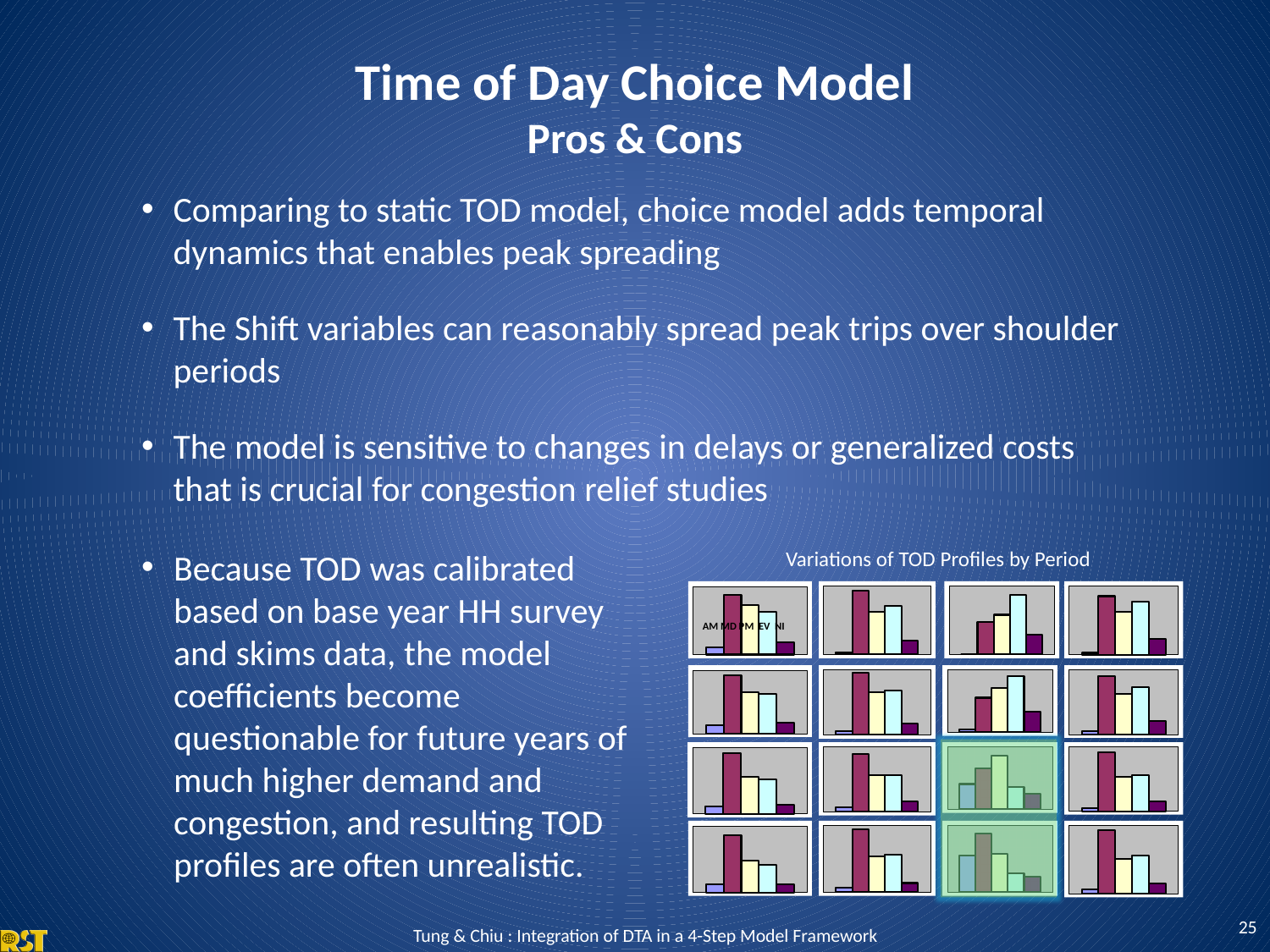
In the top-left chart of the 'Variations of TOD Profiles by Period' grid, which is larger, AM or MD? MD In the top-left chart of the 'Variations of TOD Profiles by Period' grid, which category has the shortest bar? AM What are the category labels shown on the top-left chart of the 'Variations of TOD Profiles by Period' grid? AM, MD, PM, EV, NI How many bars (categories) does each small chart in the 'Variations of TOD Profiles by Period' grid have? 5 In the top-left chart of the 'Variations of TOD Profiles by Period' grid, which is larger, PM or NI? PM In the top-left chart of the 'Variations of TOD Profiles by Period' grid, which is larger, MD or NI? MD What is the title shown above the grid of small charts? Variations of TOD Profiles by Period In the top-left chart of the 'Variations of TOD Profiles by Period' grid, which category has the tallest bar? MD How many small charts are in the 'Variations of TOD Profiles by Period' grid? 16 What kind of chart is used in the grid under 'Variations of TOD Profiles by Period'? bar chart